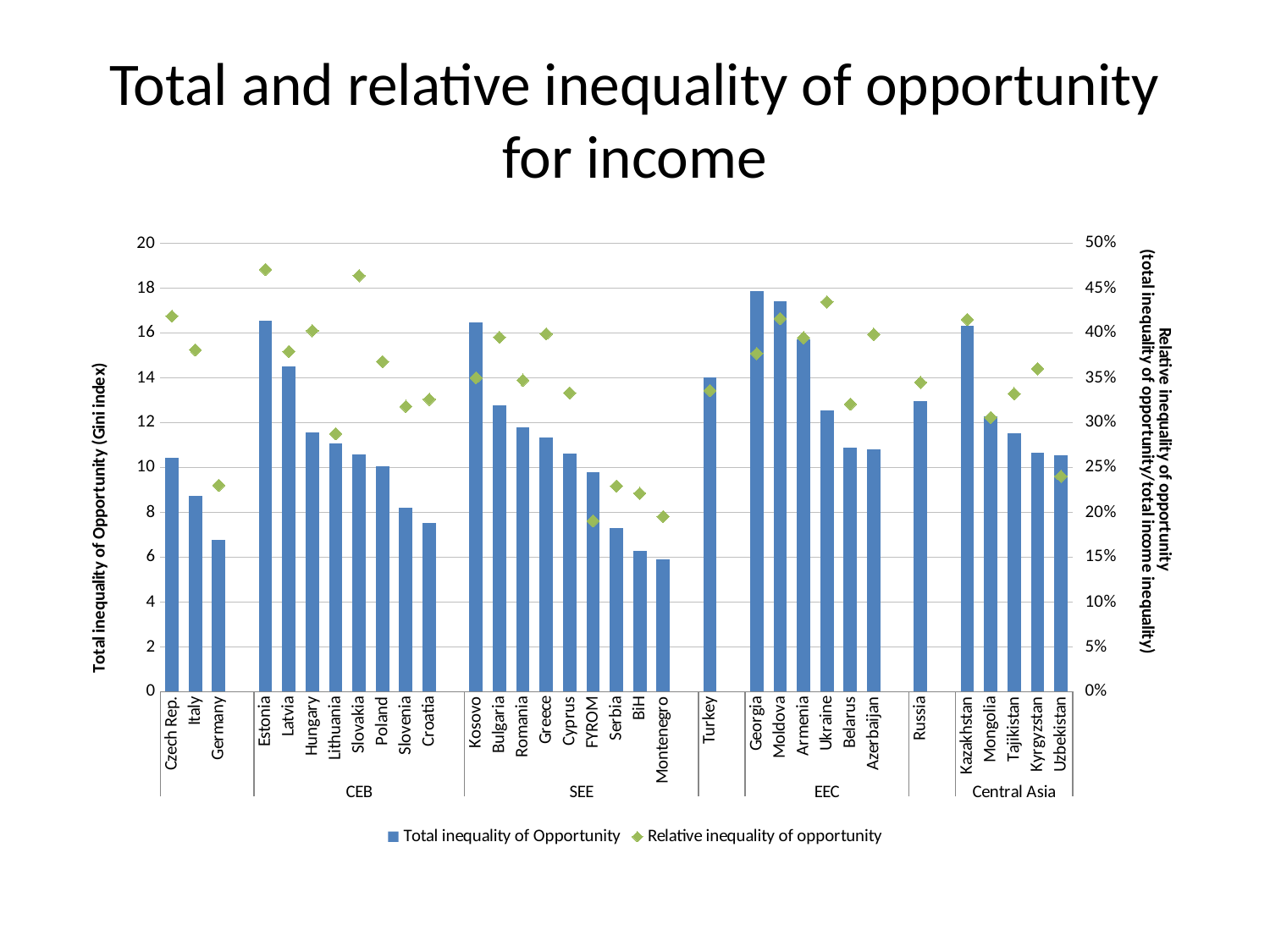
What is the title of the left vertical axis? Total inequality of Opportunity (Gini index) Is the Relative inequality of opportunity for Montenegro greater or less than 25%? less What kind of chart is shown on the slide? bar chart How many series does the legend list? 2 Which country has the lowest bar for Total inequality of Opportunity? Montenegro Is the Total inequality of Opportunity bar for Germany greater or less than 8? less Is the Total inequality of Opportunity bar for Estonia greater or less than 16? greater Which has the larger Total inequality of Opportunity bar, Kosovo or Bulgaria? Kosovo How many countries are plotted along the x axis? 33 Which has the higher Relative inequality of opportunity, Estonia or Italy? Estonia Which country has the highest Relative inequality of opportunity marker? Estonia Which country has the highest bar for Total inequality of Opportunity? Georgia